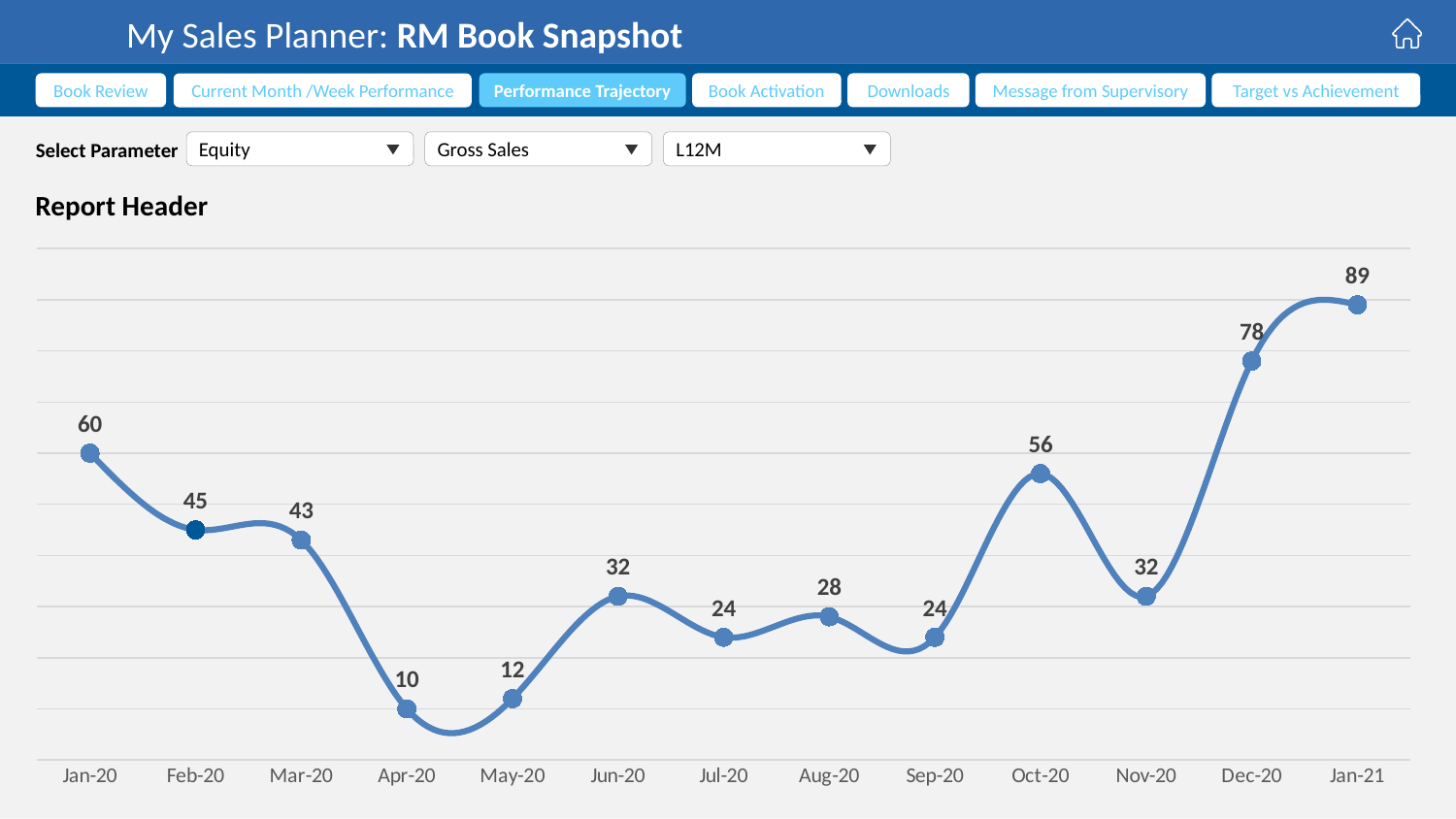
What kind of chart is shown on the slide? Line chart What is the difference between the values for Jan-20 and Feb-20? 15 Which month has the highest value? Jan-21 How many data points are plotted on the chart? 13 What is the value for Oct-20? 56 What is the value for Apr-20? 10 What is the heading shown above the chart? Report Header What is the difference between the values for Jan-21 and Dec-20? 11 Do the values rise or fall from Sep-20 to Oct-20? Rise Which is larger, the value for Jun-20 or the value for Aug-20? Jun-20 What is the value for Jan-20? 60 Which month has the lowest value? Apr-20